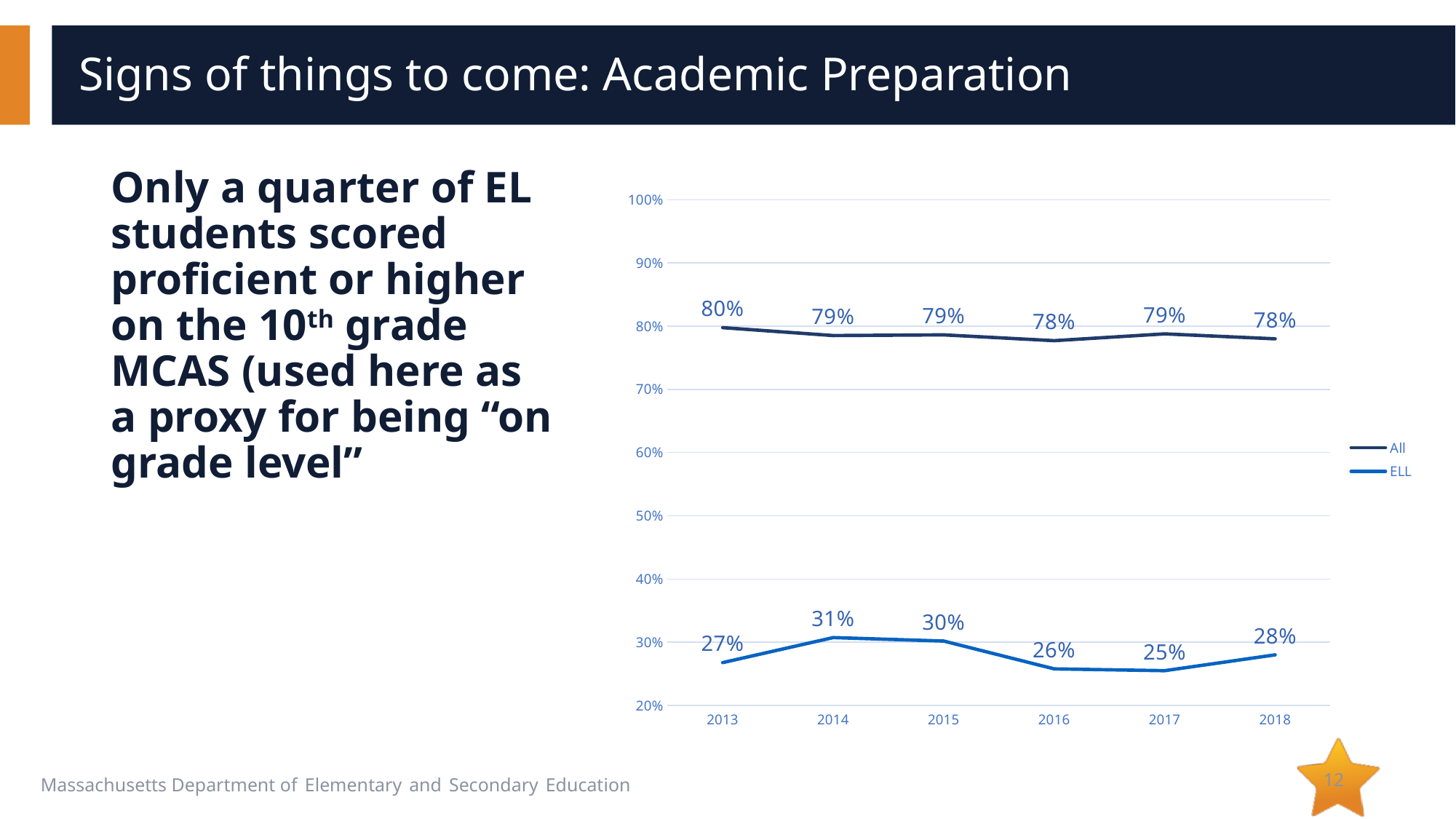
What is the value for ELL in 2017? 25% What is the value for All in 2013? 80% How many series does the legend list? 2 What kind of chart is shown on the slide? line chart Which is larger, the ELL value in 2015 or the ELL value in 2016? 2015 What are the two series listed in the legend? All and ELL Does the All series rise or fall from 2013 to 2018? fall What is the difference between the All and ELL values in 2018? 50% In which year is the ELL value lowest? 2017 What is the value for ELL in 2014? 31% In which year is the ELL value highest? 2014 How many years are shown on the x axis? 6